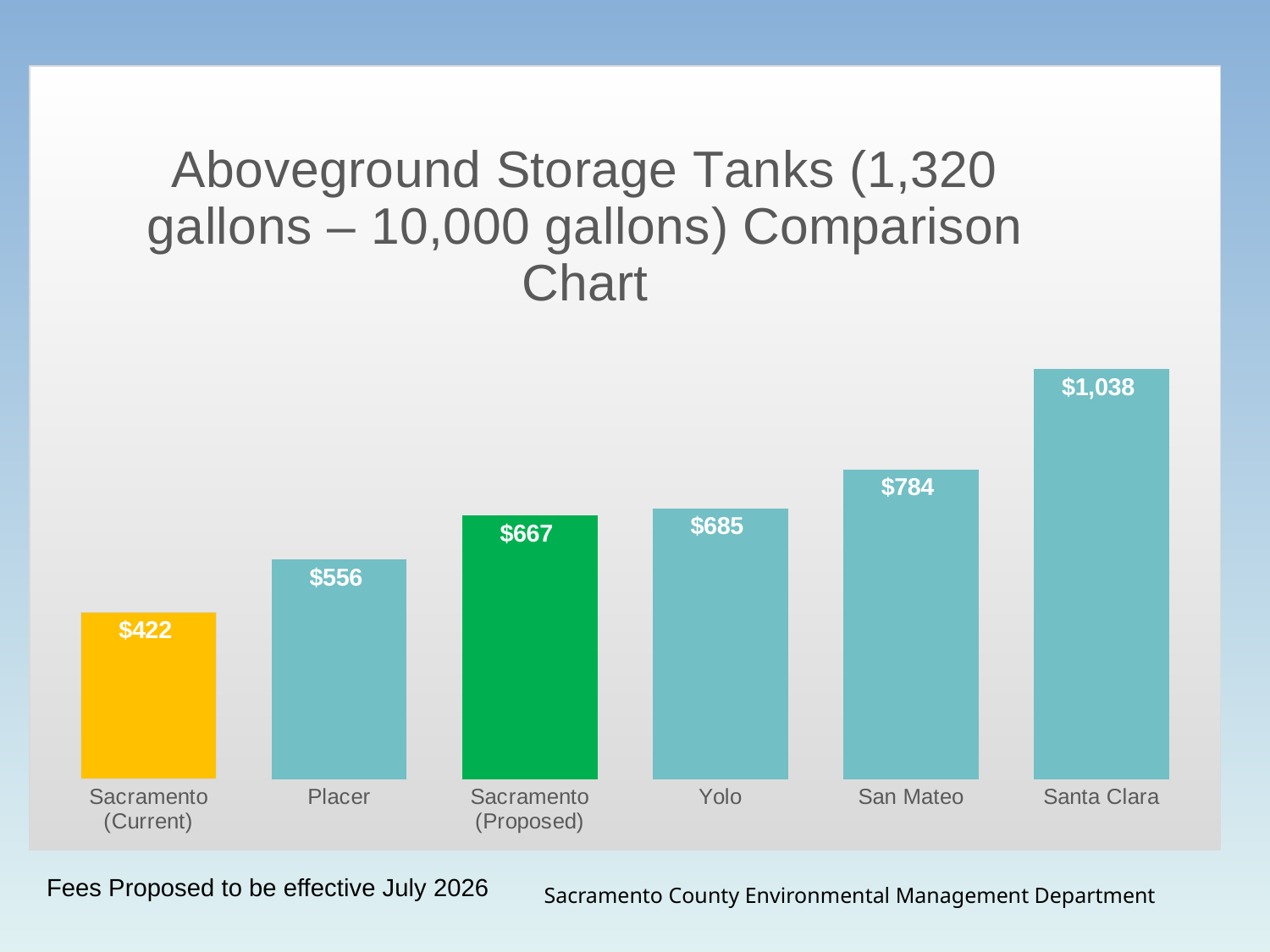
Which category has the highest value? Santa Clara What is the difference between the Sacramento (Proposed) and Sacramento (Current) values? $245 Which bar is coloured green? Sacramento (Proposed) What kind of chart is shown on the slide? Bar chart What is the difference between the Santa Clara and Yolo values? $353 What is the value for Sacramento (Current)? $422 What is the value for San Mateo? $784 Which is larger, the value for Yolo or the value for Placer? Yolo What is the value for Sacramento (Proposed)? $667 How many categories are shown in the chart? 6 Which category has the lowest value? Sacramento (Current) What is the value for Placer? $556